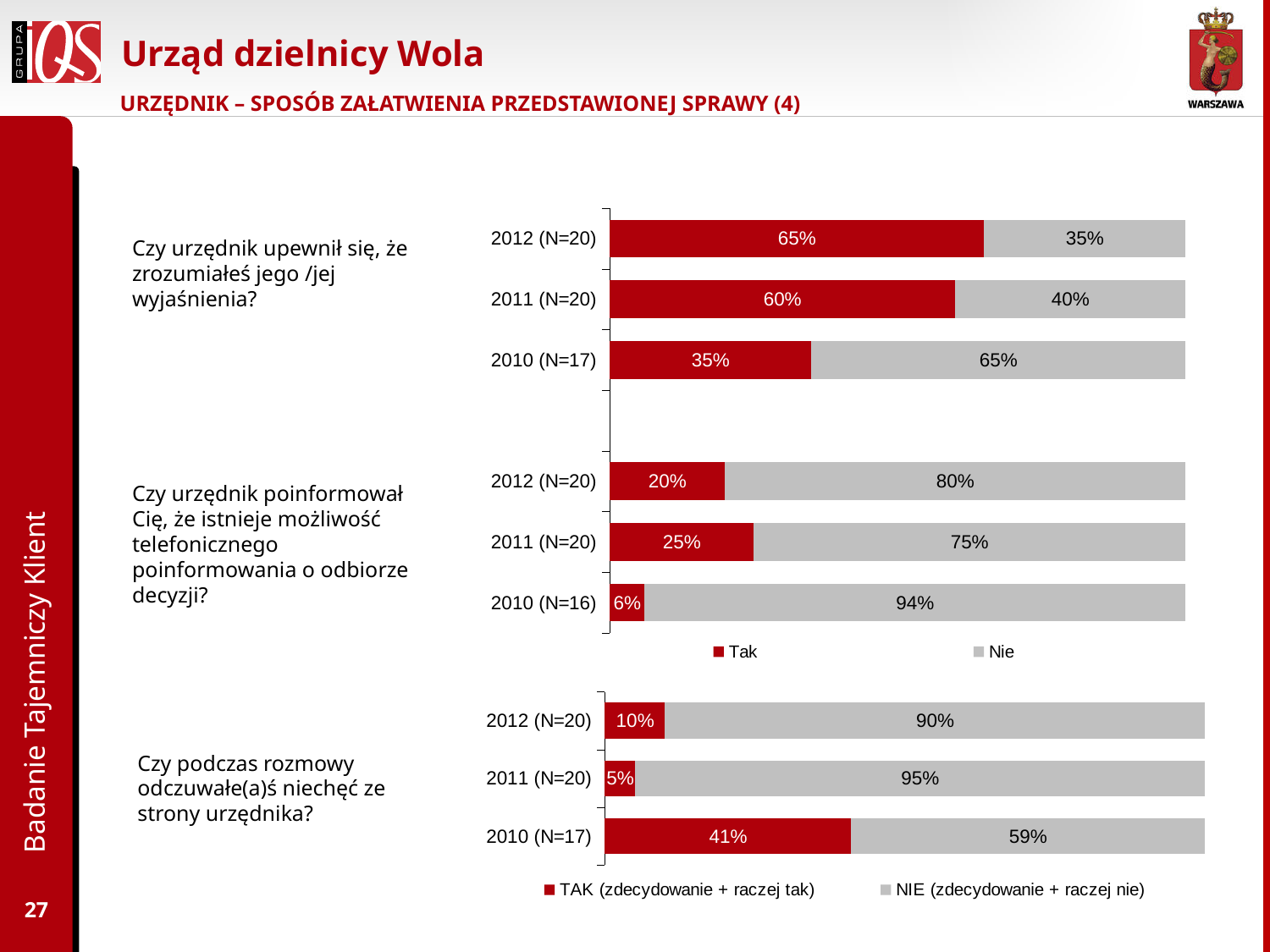
In the top chart, for the question 'Czy urzędnik upewnił się, że zrozumiałeś jego /jej wyjaśnienia?', what is the difference between the 'Tak' values for 2012 (N=20) and 2010 (N=17)? 30 percentage points In the top chart, for the question 'Czy urzędnik upewnił się, że zrozumiałeś jego /jej wyjaśnienia?', what is the 'Nie' value for 2010 (N=17)? 65% How many series does the legend of the top chart list? 2 In the bottom chart ('Czy podczas rozmowy odczuwałe(a)ś niechęć ze strony urzędnika?'), which is larger: the 'NIE' value for 2012 (N=20) or for 2010 (N=17)? 2012 (N=20) In the bottom chart ('Czy podczas rozmowy odczuwałe(a)ś niechęć ze strony urzędnika?'), which year has the lowest 'TAK' value? 2011 (N=20) In the bottom chart ('Czy podczas rozmowy odczuwałe(a)ś niechęć ze strony urzędnika?'), what is the 'TAK' value for 2010 (N=17)? 41% In the top chart, for the question 'Czy urzędnik poinformował Cię, że istnieje możliwość telefonicznego poinformowania o odbiorze decyzji?', which year has the highest 'Nie' value? 2010 (N=16) In the top chart, for the question 'Czy urzędnik upewnił się, że zrozumiałeś jego /jej wyjaśnienia?', does the 'Tak' value rise or fall from 2010 to 2012? rise What type of chart is used on this slide? Stacked bar chart In the top chart, for the question 'Czy urzędnik poinformował Cię, że istnieje możliwość telefonicznego poinformowania o odbiorze decyzji?', what is the 'Tak' value for 2010 (N=16)? 6% In the top chart, for the question 'Czy urzędnik upewnił się, że zrozumiałeś jego /jej wyjaśnienia?', what is the 'Tak' value for 2012 (N=20)? 65% How many bars (year categories) are shown in the bottom chart? 3